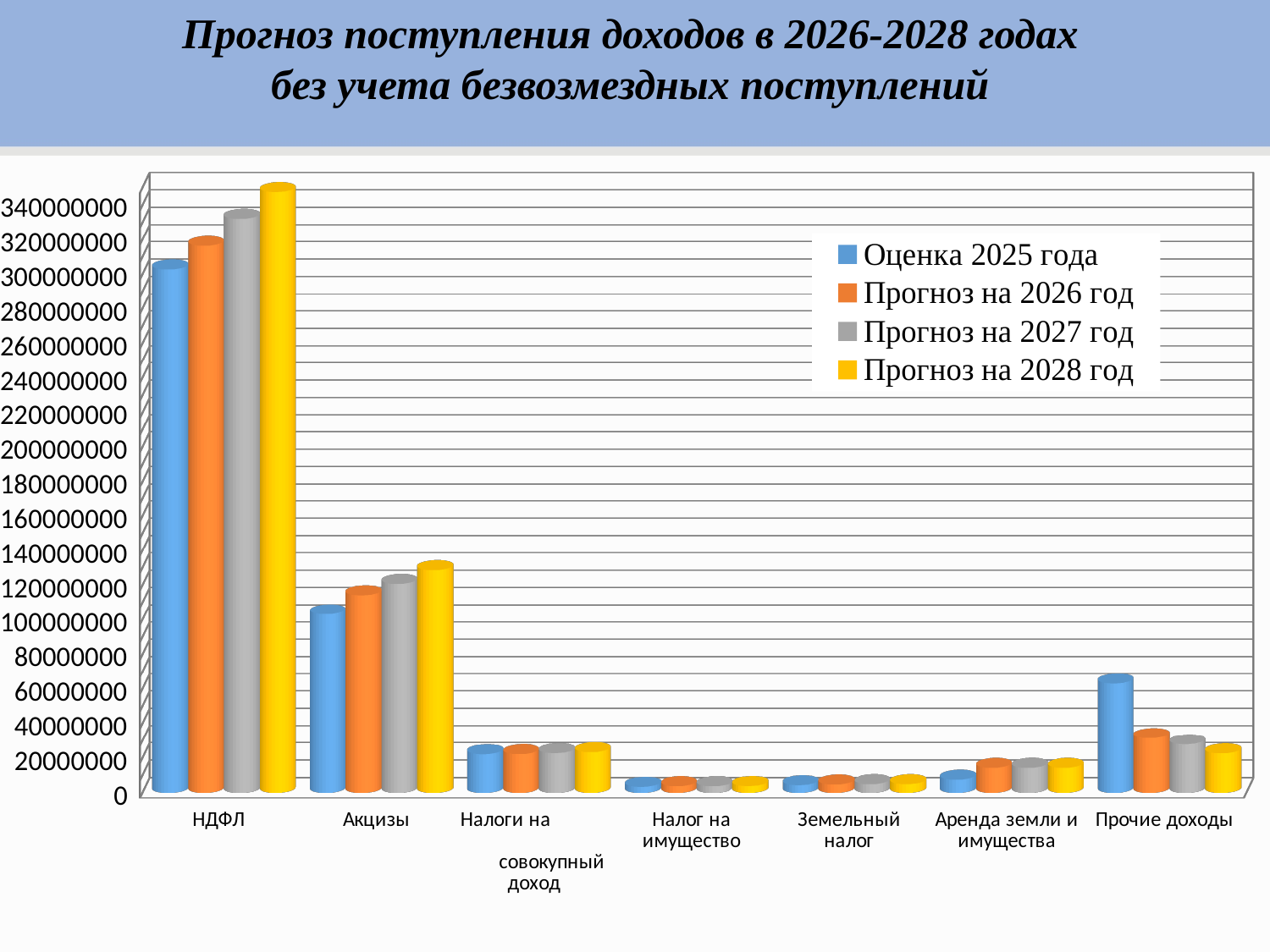
How many categories are shown on the x axis? 7 Is the value for Налог на имущество in Оценка 2025 года greater or less than 20000000? less Is the value for Прочие доходы in Оценка 2025 года greater or less than 40000000? greater Do the values for НДФЛ rise or fall from Оценка 2025 года to Прогноз на 2028 год? rise Which category has the highest values in the chart? НДФЛ Is the value for Акцизы in Прогноз на 2028 год greater or less than 120000000? greater Which is larger for Прогноз на 2028 год: Акцизы or Прочие доходы? Акцизы What kind of chart is shown on the slide? bar chart How many series does the legend list? 4 For Прочие доходы, which is larger: Оценка 2025 года or Прогноз на 2026 год? Оценка 2025 года Which category has the lowest values in the chart? Налог на имущество